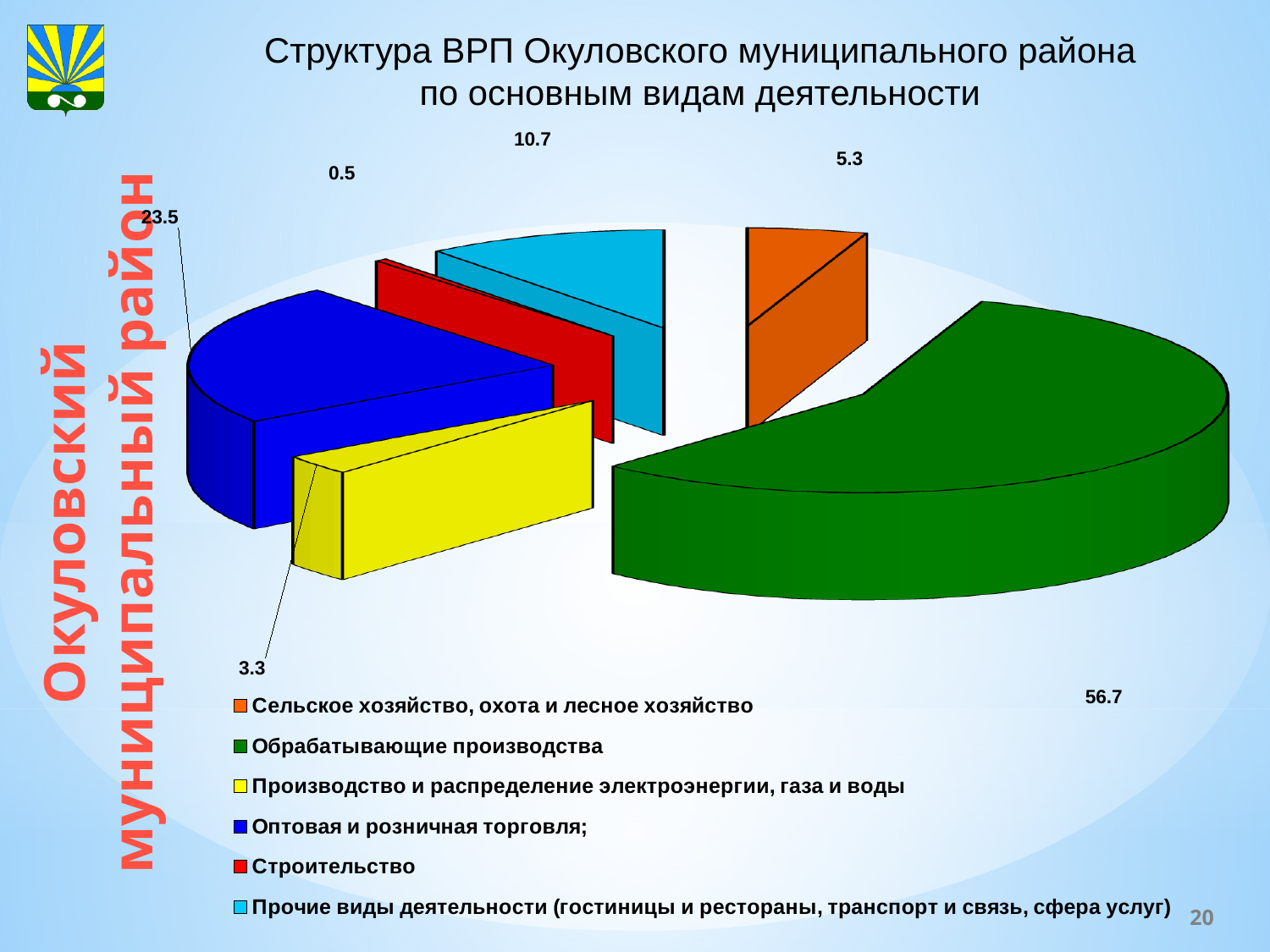
What is the value for Строительство? 0.5 What colour is the slice for Производство и распределение электроэнергии, газа и воды? yellow What is the difference between the values for Обрабатывающие производства and Оптовая и розничная торговля? 33.2 Which is larger: the value for Прочие виды деятельности or the value for Сельское хозяйство, охота и лесное хозяйство? Прочие виды деятельности What is the value for Прочие виды деятельности (гостиницы и рестораны, транспорт и связь, сфера услуг)? 10.7 Which category has the smallest share of the pie? Строительство What is the value for Оптовая и розничная торговля? 23.5 What type of chart is shown on the slide? pie chart What is the value for Обрабатывающие производства? 56.7 What is the value for Сельское хозяйство, охота и лесное хозяйство? 5.3 How many categories does the legend list? 6 Which category has the largest share of the pie? Обрабатывающие производства